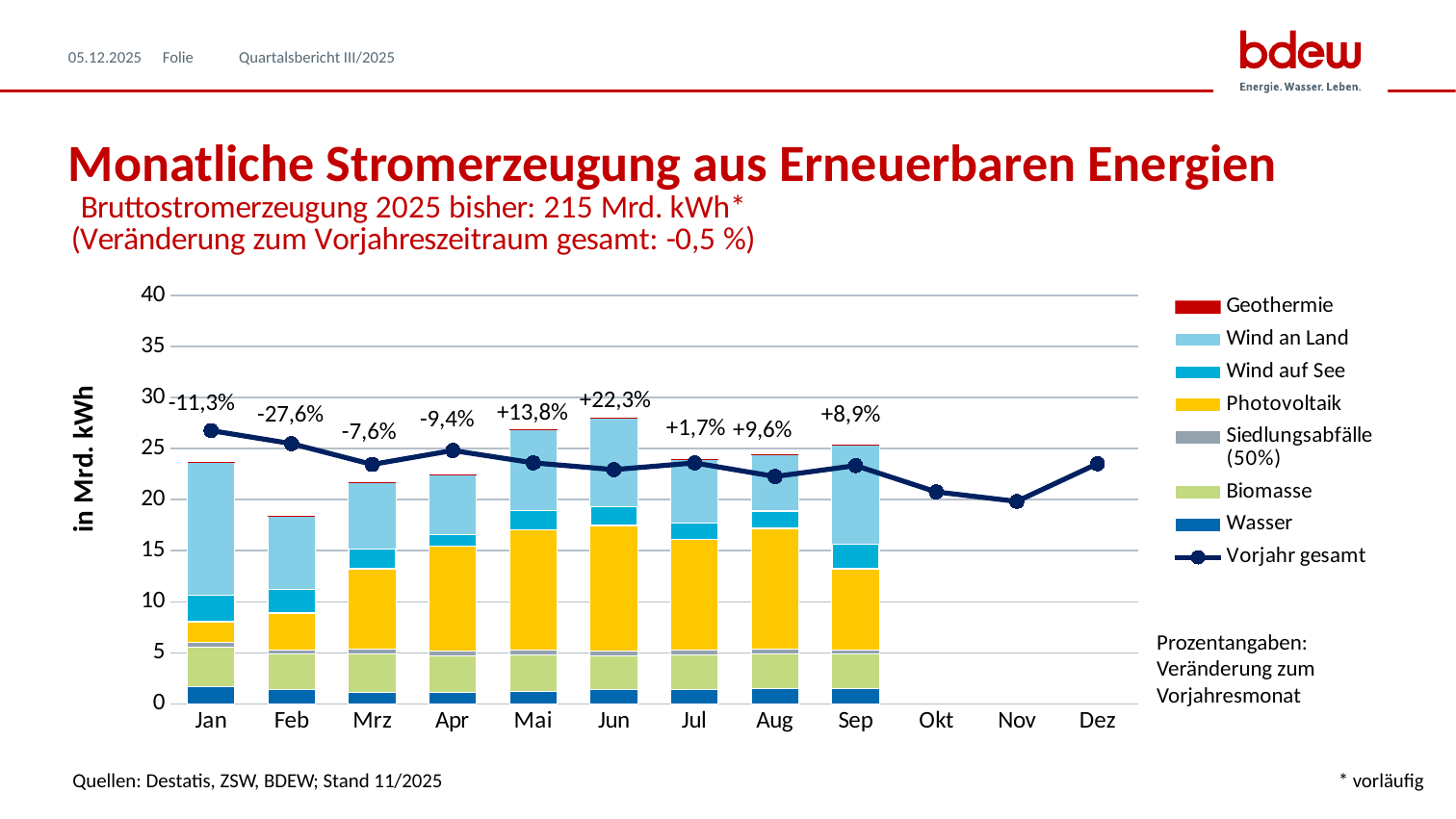
How many months have stacked bars plotted? 9 Which month has the lowest stacked bar? Feb What percentage change is shown above the bar for Jan? -11,3% How many entries does the legend list? 8 What kind of chart is shown? stacked bar chart with a line Which month has the lowest percentage change label? Feb What percentage change is shown above the bar for Jun? +22,3% Is the total stacked bar for Feb greater or less than 20? less Is the total stacked bar for Jun greater or less than 25? greater What percentage change is shown above the bar for Sep? +8,9% What percentage change is shown above the bar for Feb? -27,6% Which month has the highest percentage change label? Jun